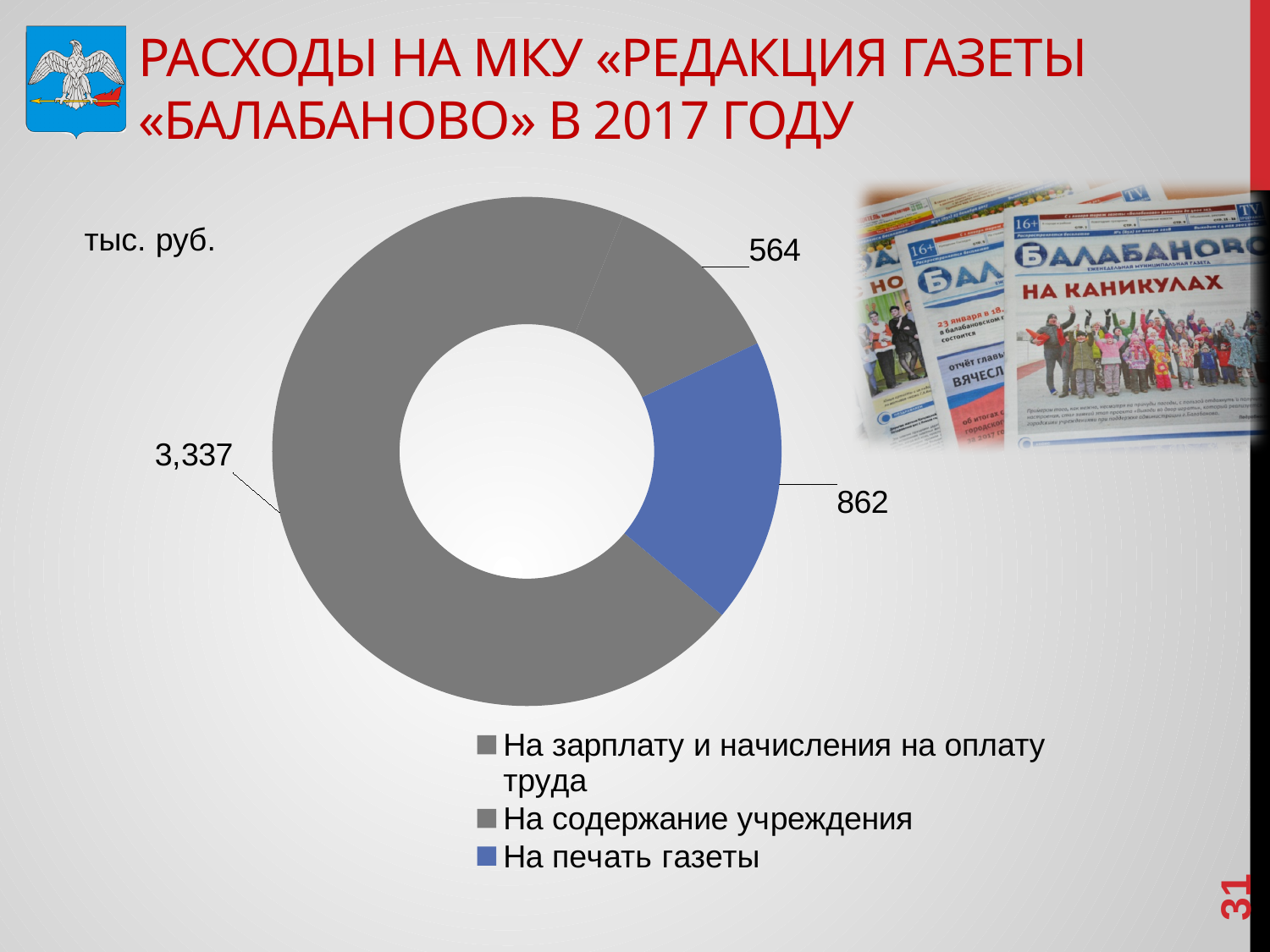
What is the value for "На печать газеты"? 862 What is the value for "На содержание учреждения"? 564 What type of chart is shown on the slide? Doughnut (pie) chart How many categories does the chart show? 3 Which is larger: the value for "На печать газеты" or for "На содержание учреждения"? На печать газеты What is the total of all three values shown on the chart? 4,763 What is the difference between the values for "На зарплату и начисления на оплату труда" and "На печать газеты"? 2,475 What unit is indicated for the chart values? тыс. руб. Which category has the smallest value? На содержание учреждения What is the difference between the values for "На печать газеты" and "На содержание учреждения"? 298 Which category has the largest value? На зарплату и начисления на оплату труда What is the value for "На зарплату и начисления на оплату труда"? 3,337